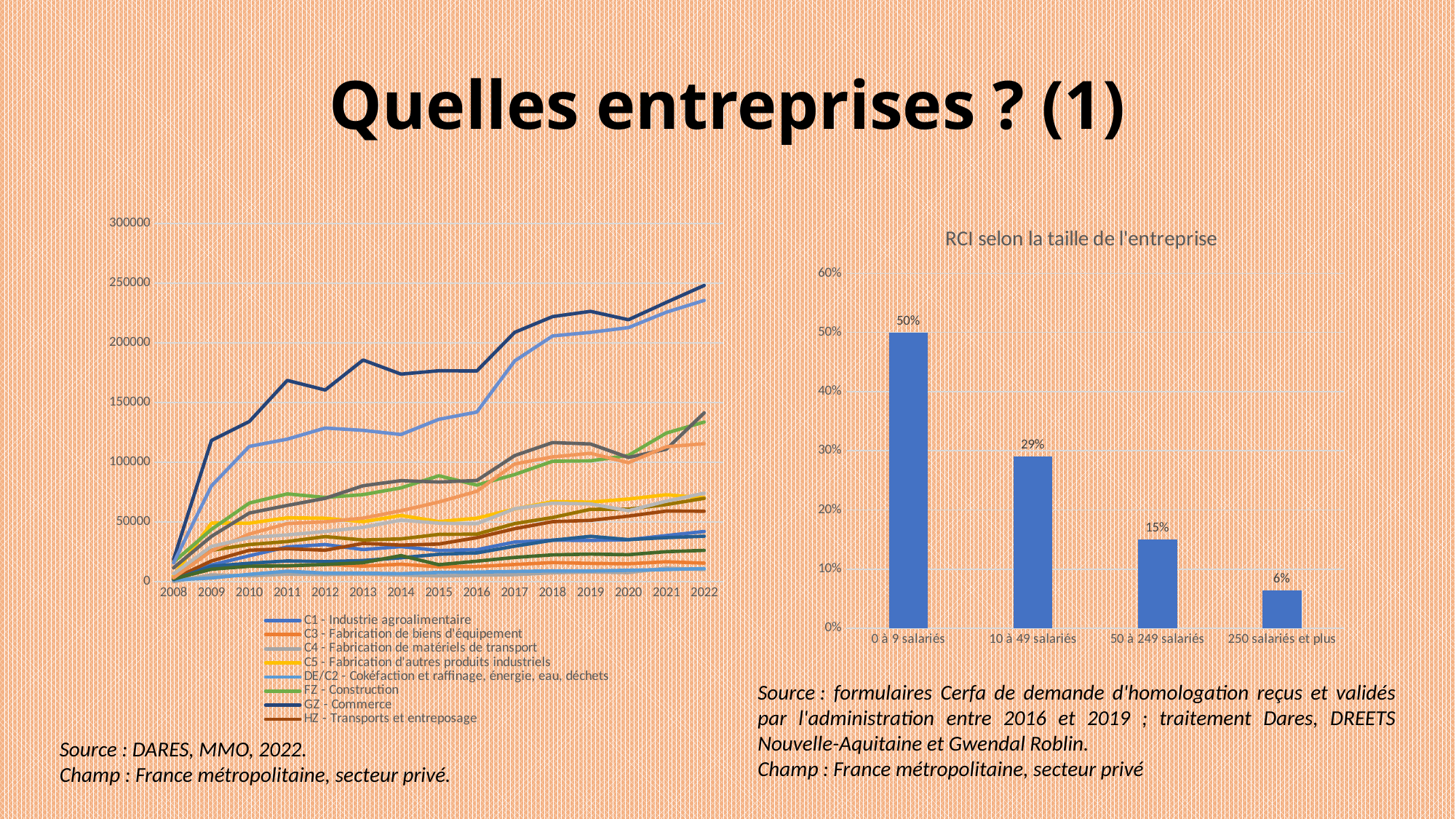
What kind of chart is the one on the right of the slide? bar chart On the chart titled 'RCI selon la taille de l'entreprise', do the values rise or fall from left to right along the x axis? fall On the chart titled 'RCI selon la taille de l'entreprise', which category has the highest value? 0 à 9 salariés On the chart titled 'RCI selon la taille de l'entreprise', what is the value for '50 à 249 salariés'? 15% On the chart titled 'RCI selon la taille de l'entreprise', which is larger: the value for '10 à 49 salariés' or for '250 salariés et plus'? 10 à 49 salariés What kind of chart is the one on the left of the slide? line chart On the chart titled 'RCI selon la taille de l'entreprise', what is the value for '0 à 9 salariés'? 50% On the line chart on the left of the slide, is the value for 'GZ - Commerce' in 2022 greater or less than 200000? greater On the chart titled 'RCI selon la taille de l'entreprise', what is the difference between the values for '0 à 9 salariés' and '10 à 49 salariés'? 21 percentage points On the chart titled 'RCI selon la taille de l'entreprise', how many categories are shown on the x axis? 4 On the chart titled 'RCI selon la taille de l'entreprise', which category has the lowest value? 250 salariés et plus On the line chart on the left of the slide, how many years are shown on the x axis? 15